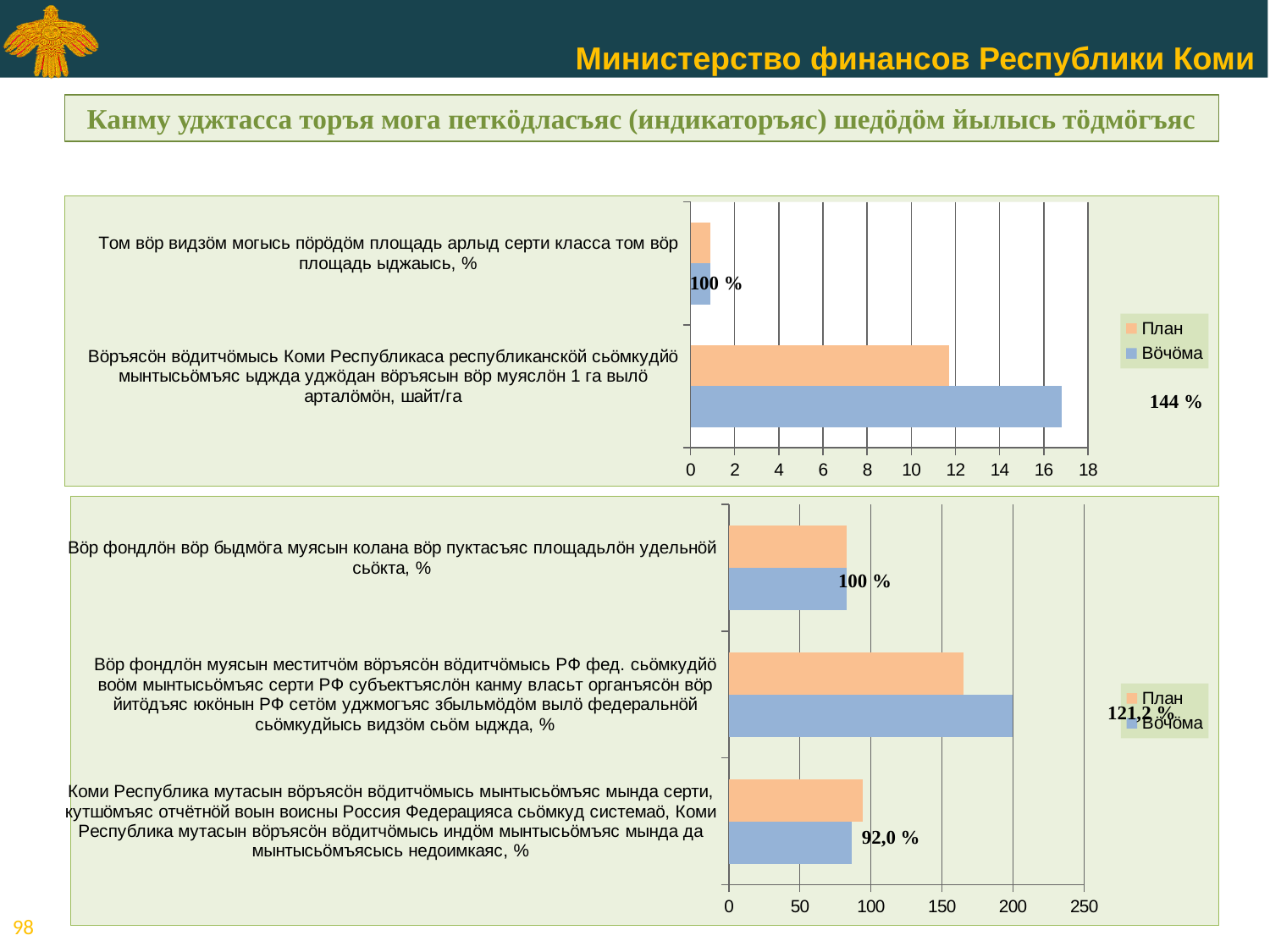
In the bottom chart, is the Вöчöма value for the second category greater or less than 150? greater In the bottom chart, which category has the highest Вöчöма value? the second category (Вöр фондлöн муясын меститчöм вöръясöн вöдитчöмысь РФ фед. сьöмкудйö ...) In the top chart, is the Вöчöма value for the second category (шайт/га) greater or less than 14? greater In the bottom chart, which colour represents the План series? orange What are the two legend entries of the bottom chart? План and Вöчöма In the bottom chart, is the План value for the third category (Коми Республика мутасын ... недоимкаяс, %) greater or less than 100? less How many categories are plotted in the bottom chart? 3 What kind of chart is the top chart on the slide? bar chart How many series does the legend of the top chart list? 2 In the top chart, for the second category (Вöръясöн вöдитчöмысь ... шайт/га), which series has the larger value, План or Вöчöма? Вöчöма How many categories are plotted in the top chart? 2